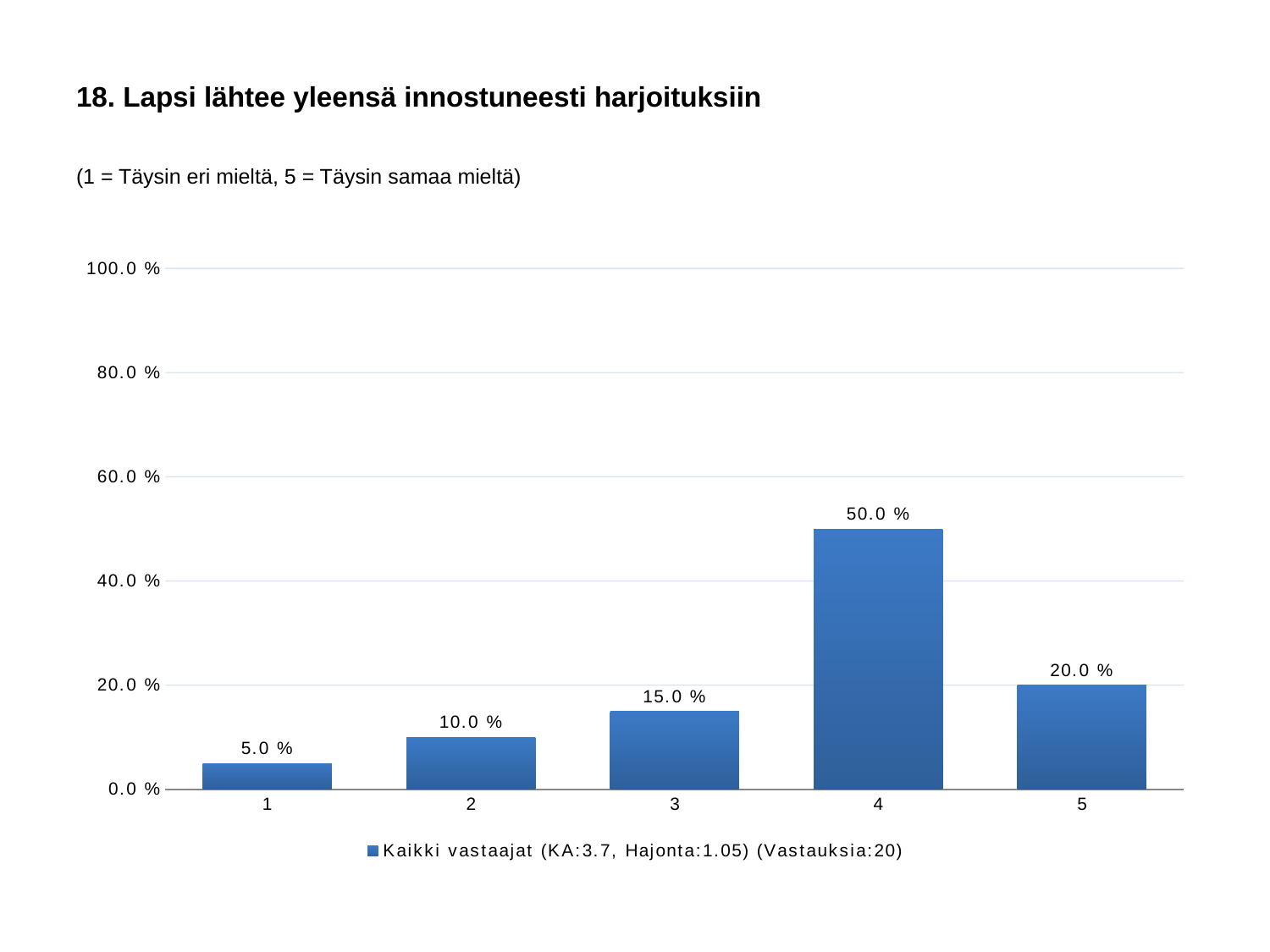
What is the legend entry for the series? Kaikki vastaajat (KA:3.7, Hajonta:1.05) (Vastauksia:20) Is the value for category 4 greater or less than 40.0 %? greater What kind of chart is shown on the slide? bar chart What is the value for category 4? 50.0 % Which category has the lowest value? 1 Which category has the highest value? 4 How many categories are shown on the x axis? 5 Which is larger, the value for category 3 or the value for category 2? 3 How many series does the legend list? 1 What is the difference between the values for category 4 and category 5? 30.0 % What is the value for category 5? 20.0 % What is the value for category 1? 5.0 %